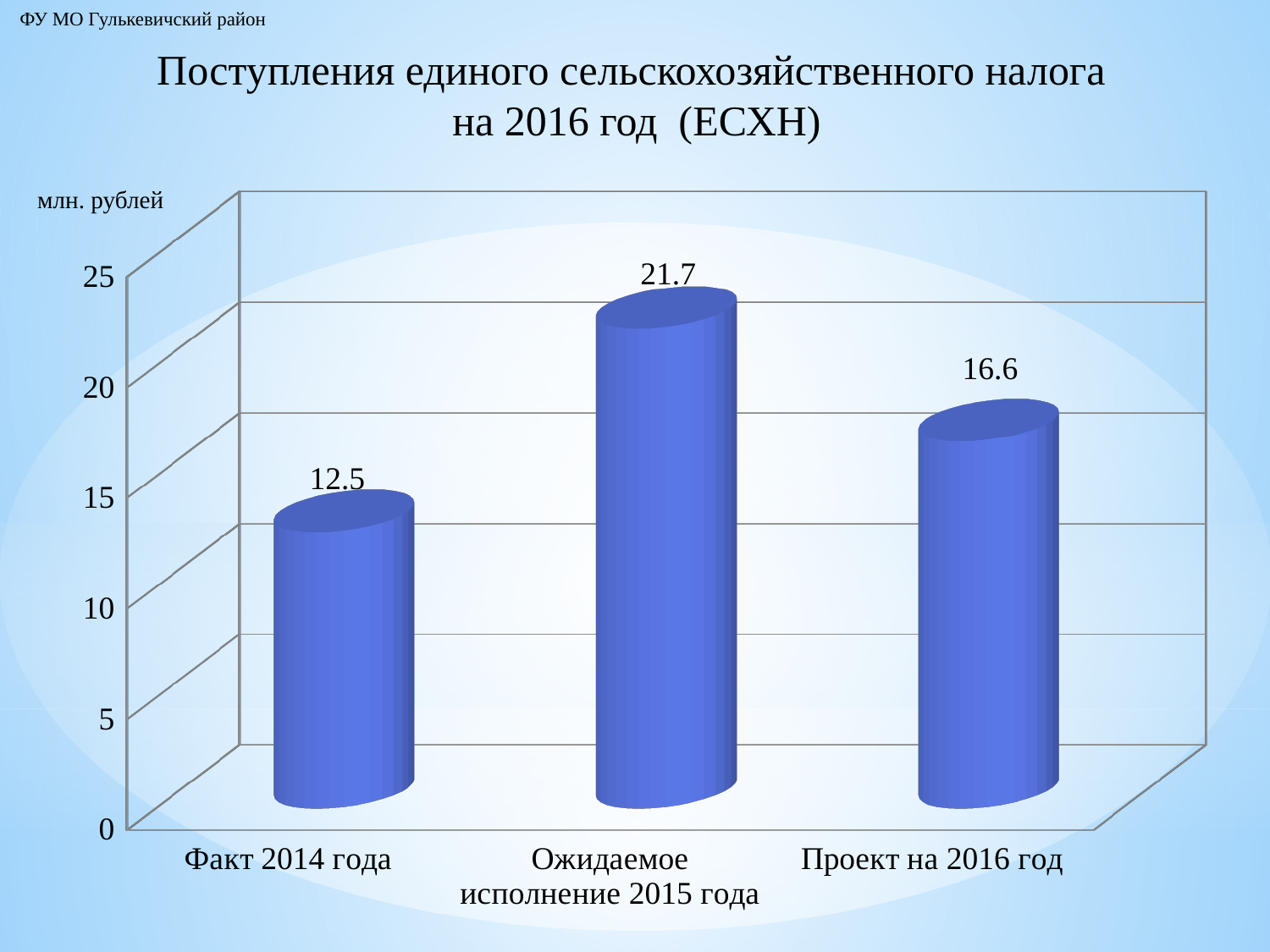
What is the value for Ожидаемое исполнение 2015 года? 21.7 Which category has the lowest value? Факт 2014 года How many categories are shown in the chart? 3 Which is larger, the value for Проект на 2016 год or the value for Факт 2014 года? Проект на 2016 год What kind of chart is shown on the slide? bar chart Is the value for Проект на 2016 год greater or less than 20? less What unit is shown on the chart's vertical axis? млн. рублей What is the value for Проект на 2016 год? 16.6 What is the difference between the values for Ожидаемое исполнение 2015 года and Факт 2014 года? 9.2 What is the difference between the values for Ожидаемое исполнение 2015 года and Проект на 2016 год? 5.1 Which category has the highest value? Ожидаемое исполнение 2015 года What is the value for Факт 2014 года? 12.5